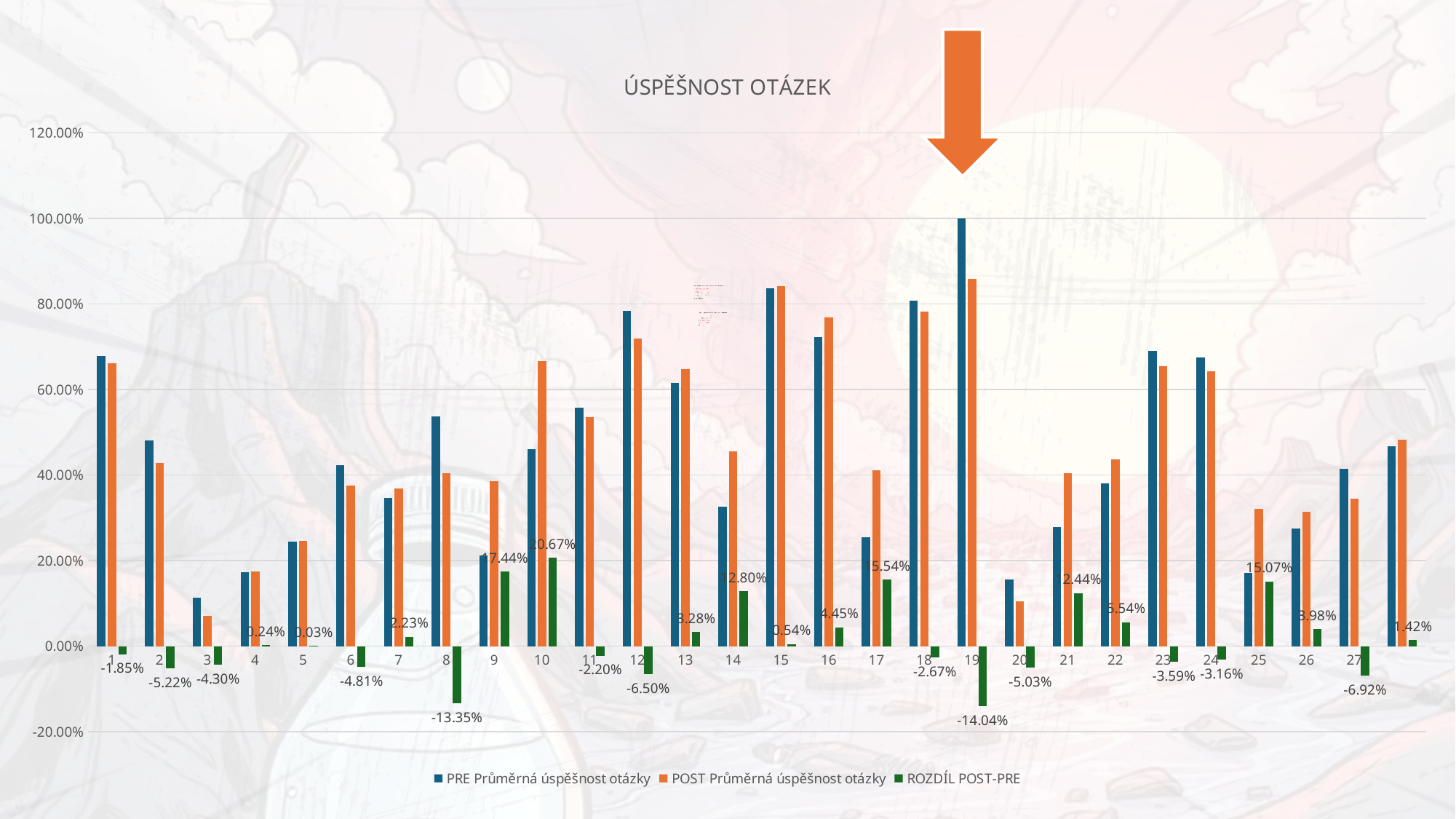
What is the ROZDÍL POST-PRE value for question 19? -14.04% What kind of chart is shown on the slide? bar chart How many series does the legend list? 3 Which question has the lowest ROZDÍL POST-PRE value? 19 What is the ROZDÍL POST-PRE value for question 8? -13.35% What is the PRE Průměrná úspěšnost otázky value for question 19? 100.00% What is the title of the chart? ÚSPĚŠNOST OTÁZEK Is the PRE Průměrná úspěšnost otázky value for question 15 greater or less than 80.00%? greater What is the difference between the ROZDÍL POST-PRE values for question 10 and question 9? 3.23% What is the ROZDÍL POST-PRE value for question 10? 20.67% Which is larger, the ROZDÍL POST-PRE value for question 17 or for question 25? question 17 Which question has the highest ROZDÍL POST-PRE value? 10